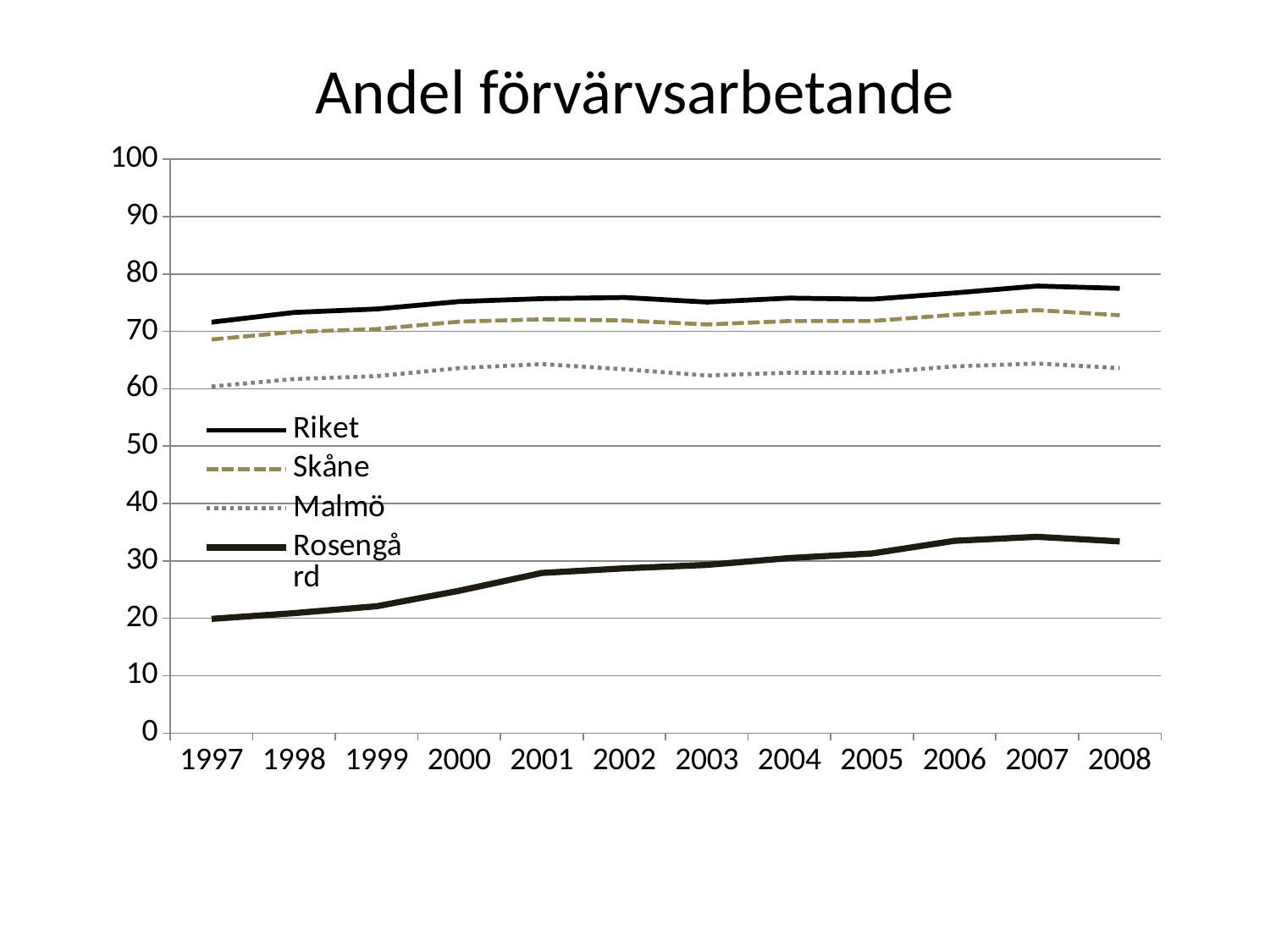
Which series has the highest value in 2008? Riket What is the title of the chart? Andel förvärvsarbetande Is the value for Skåne in 2008 greater or less than 80? less Is the value for Rosengård in 1997 greater or less than 30? less How many years are shown on the x axis? 12 Does the value for Rosengård rise or fall from 1997 to 2008? rise What kind of chart is shown on the slide? line chart Which series is drawn with a dotted line? Malmö Which series has the lowest value in 2008? Rosengård Is the value for Riket in 2007 greater or less than 70? greater How many series does the legend list? 4 Which is larger in 2008, the value for Riket or the value for Rosengård? Riket